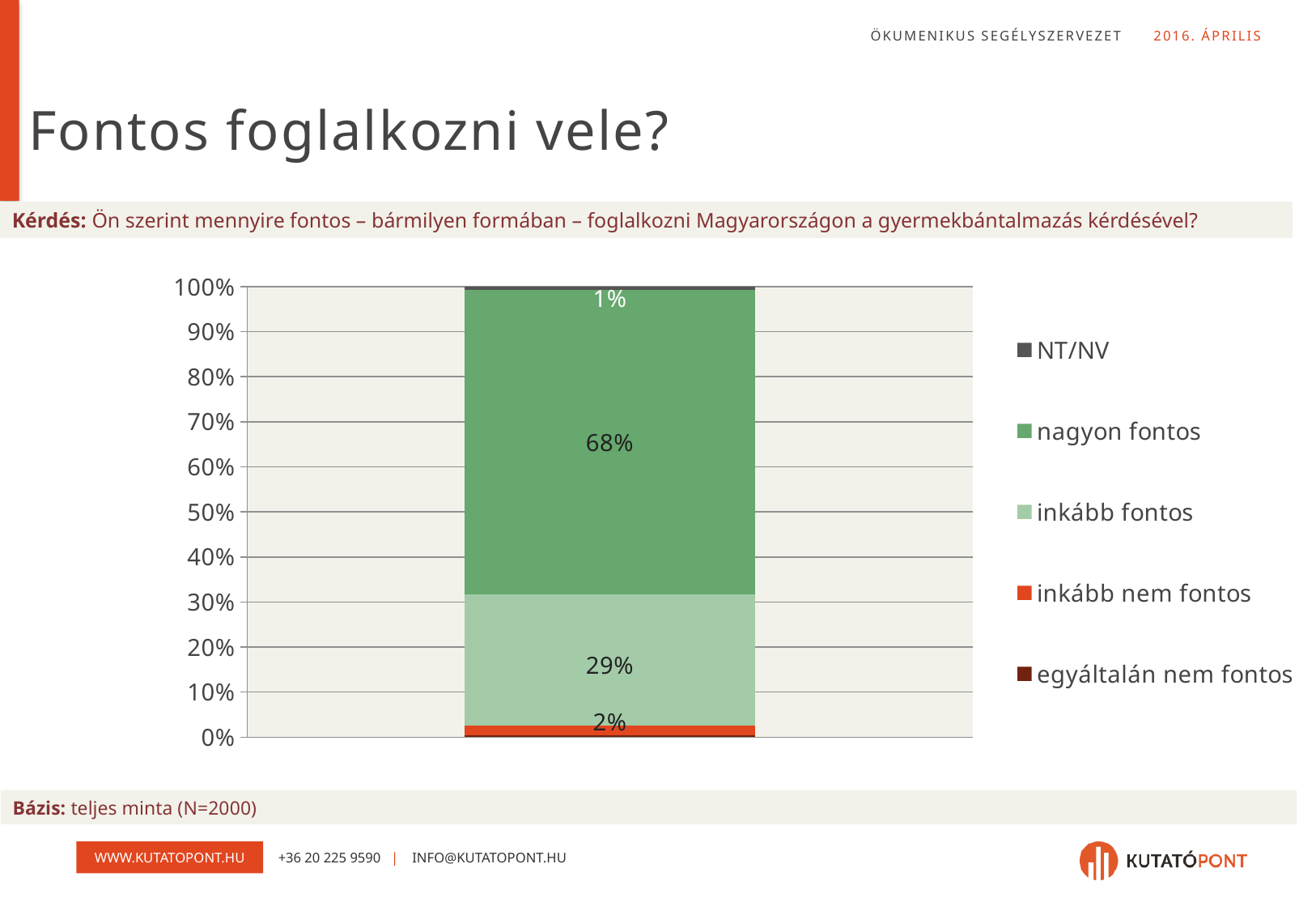
How many bars are plotted in the chart? 1 What percentage is shown for the "NT/NV" segment? 1% What kind of chart is shown on the slide? stacked bar chart How many series does the legend list? 5 What percentage of respondents answered "inkább fontos"? 29% Which legend entry is shown in red? inkább nem fontos What percentage of respondents answered "nagyon fontos"? 68% What is the last entry listed in the legend? egyáltalán nem fontos Which response category has the largest share in the stacked bar? nagyon fontos What percentage of respondents answered "inkább nem fontos"? 2% What is the difference in percentage points between "nagyon fontos" and "inkább fontos"? 39 Which is larger, the share for "inkább fontos" or the share for "inkább nem fontos"? inkább fontos